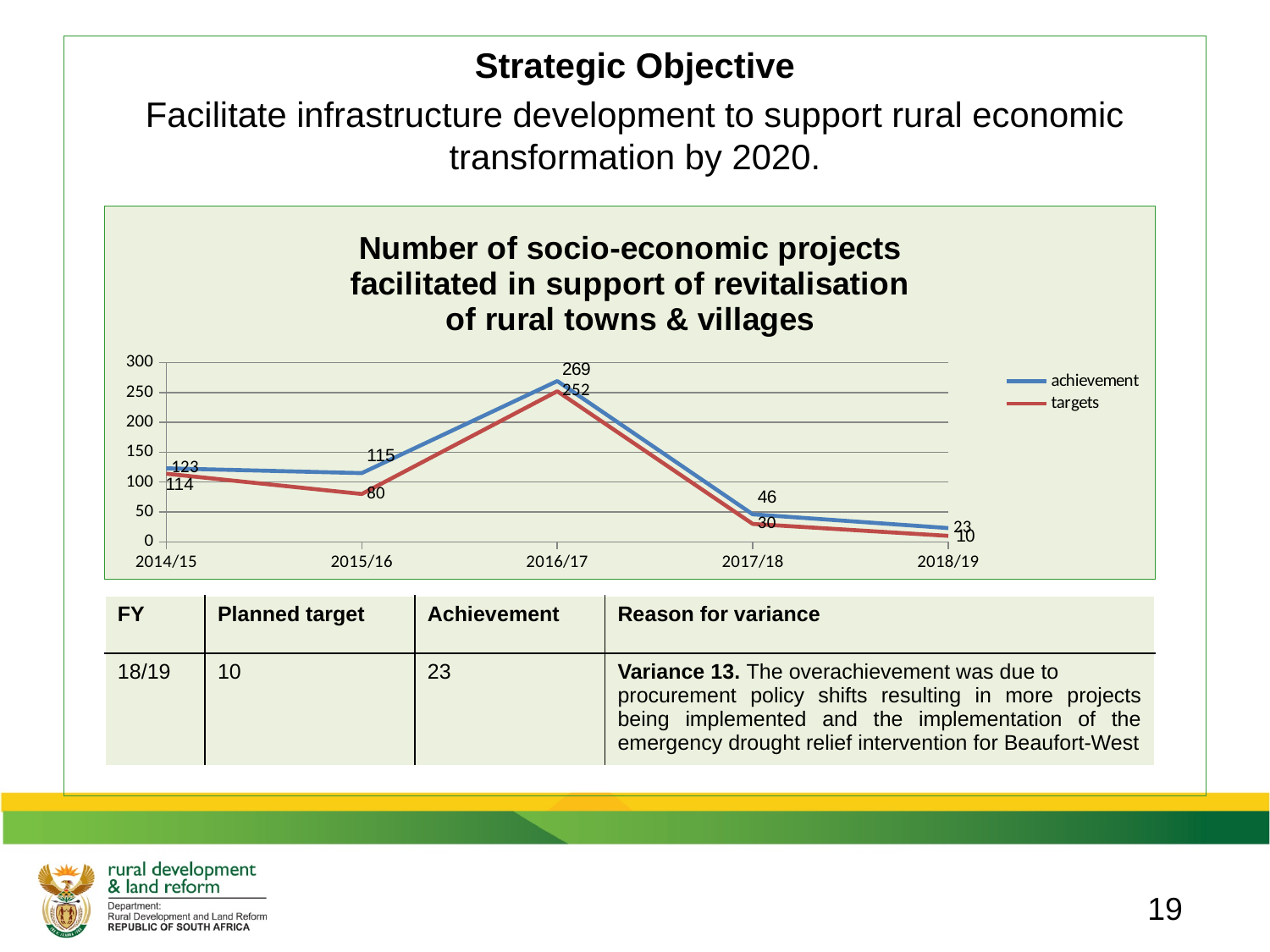
What was the achievement value in 2018/19? 23 What type of chart is shown on the slide? line chart How many series does the legend list? 2 In which year was the achievement highest? 2016/17 In which year was the targets value lowest? 2018/19 Which colour is used for the targets line? red Which was larger in 2014/15, achievement or targets? achievement What was the achievement value in 2016/17? 269 What was the targets value in 2015/16? 80 How many financial years are plotted on the x axis? 5 Did the achievement rise or fall from 2016/17 to 2018/19? fall What is the difference between achievement and targets in 2017/18? 16